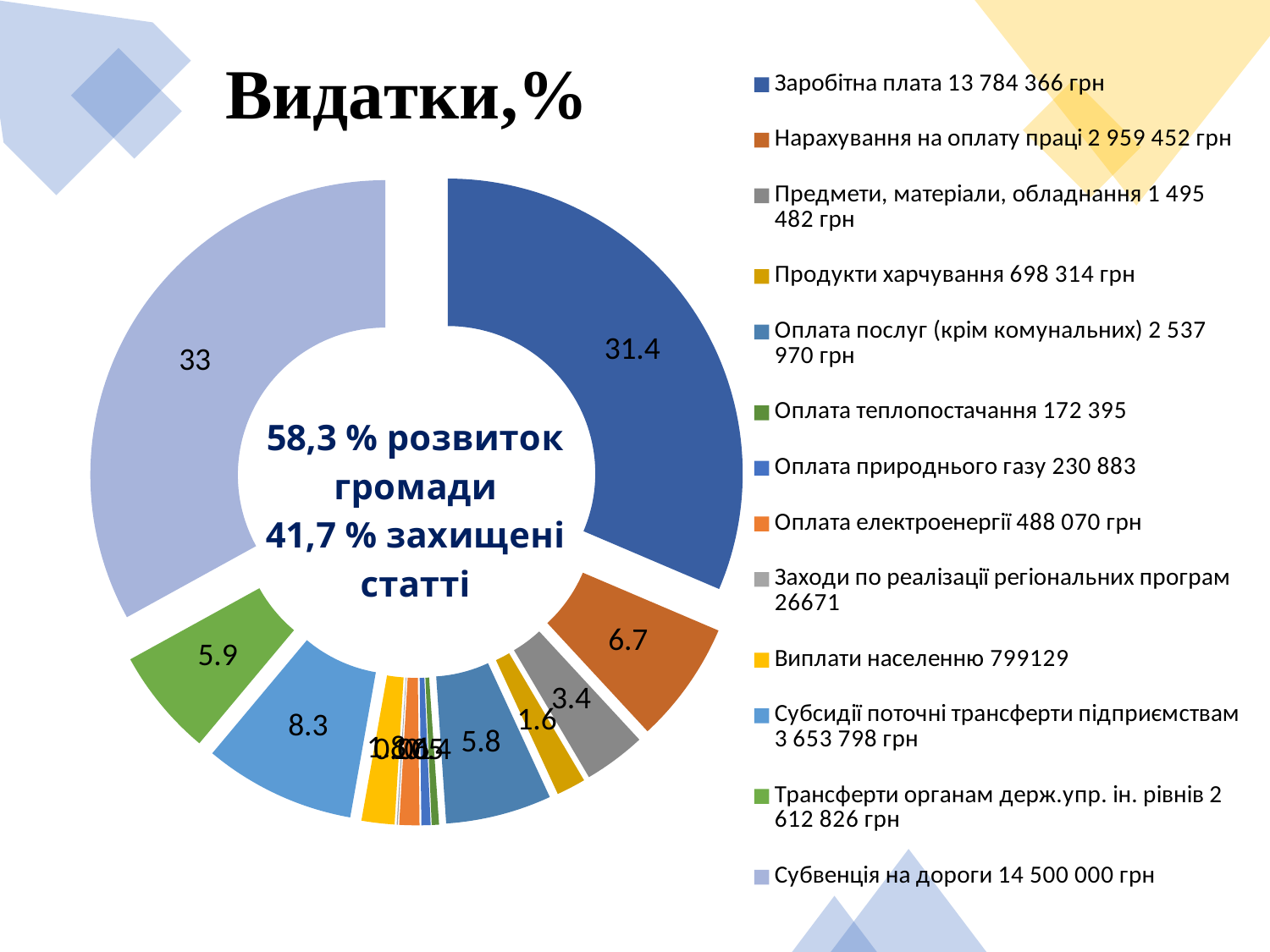
What percentage is shown for Трансферти органам держ.упр. ін. рівнів? 5.9 Which category has the largest share of the chart? Субвенція на дороги Which is larger: the share for Субсидії поточні трансферти підприємствам or for Оплата послуг (крім комунальних)? Субсидії поточні трансферти підприємствам What is the title of the chart? Видатки,% How many categories does the legend list? 13 What percentage is shown for Субсидії поточні трансферти підприємствам? 8.3 What percentage is shown for Нарахування на оплату праці? 6.7 What percentage is shown for Заробітна плата? 31.4 What percentage is shown for Субвенція на дороги? 33 What percentage is shown for Предмети, матеріали, обладнання? 3.4 What is the difference between the shares of Субвенція на дороги and Заробітна плата? 1.6 What kind of chart is shown on the slide? Doughnut (pie) chart